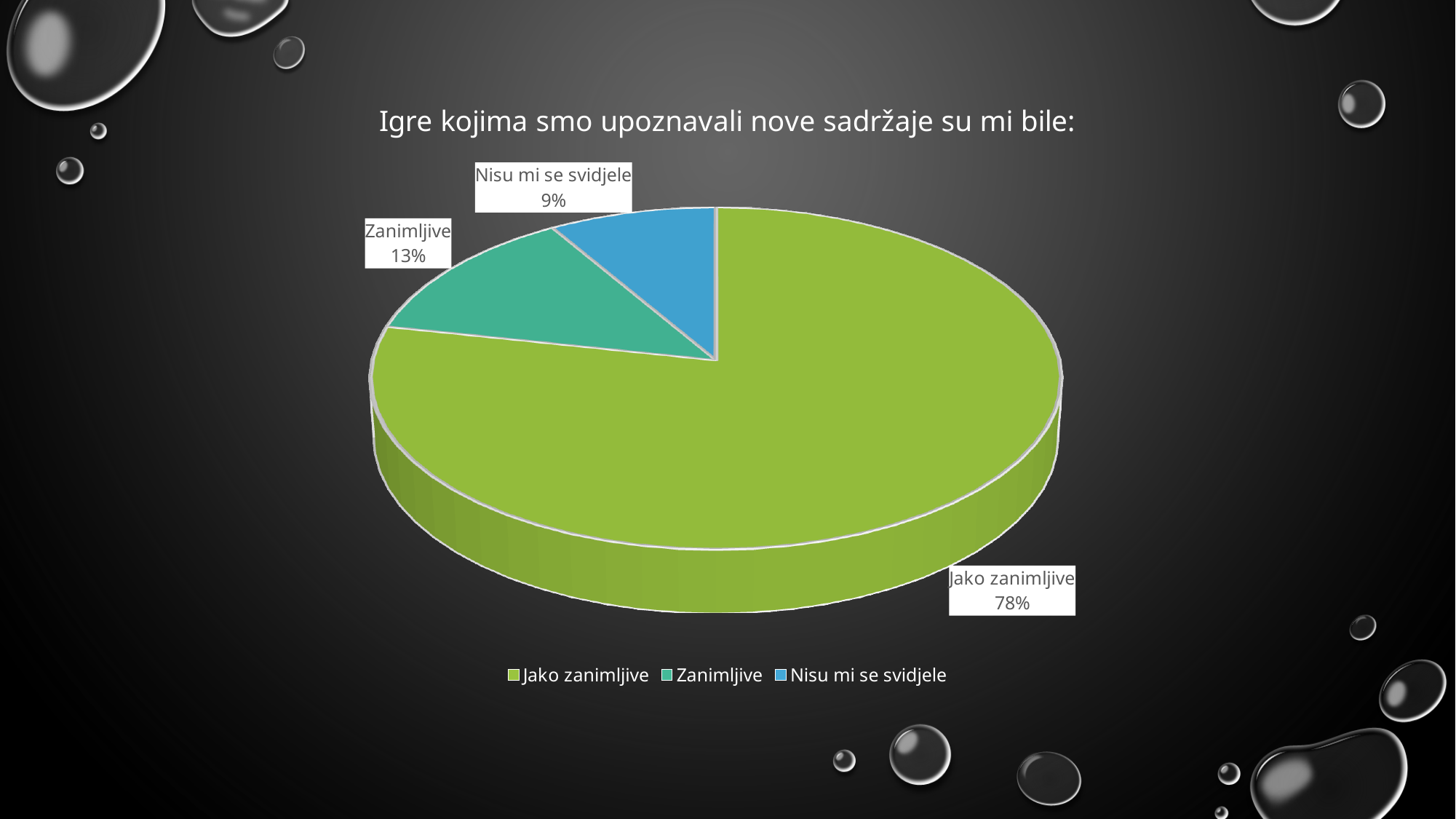
What share of the pie does "Nisu mi se svidjele" represent? 9% Which category has the smallest slice of the pie? Nisu mi se svidjele What colour is the slice for "Nisu mi se svidjele"? Blue Which is larger, the share for "Zanimljive" or the share for "Nisu mi se svidjele"? Zanimljive What is the difference in percentage points between "Zanimljive" and "Nisu mi se svidjele"? 4 What is the title of the chart? Igre kojima smo upoznavali nove sadržaje su mi bile: Which category has the largest slice of the pie? Jako zanimljive What share of the pie does "Jako zanimljive" represent? 78% What share of the pie does "Zanimljive" represent? 13% How many categories are shown in the pie chart? 3 What is the difference in percentage points between "Jako zanimljive" and "Zanimljive"? 65 What kind of chart is shown on the slide? Pie chart